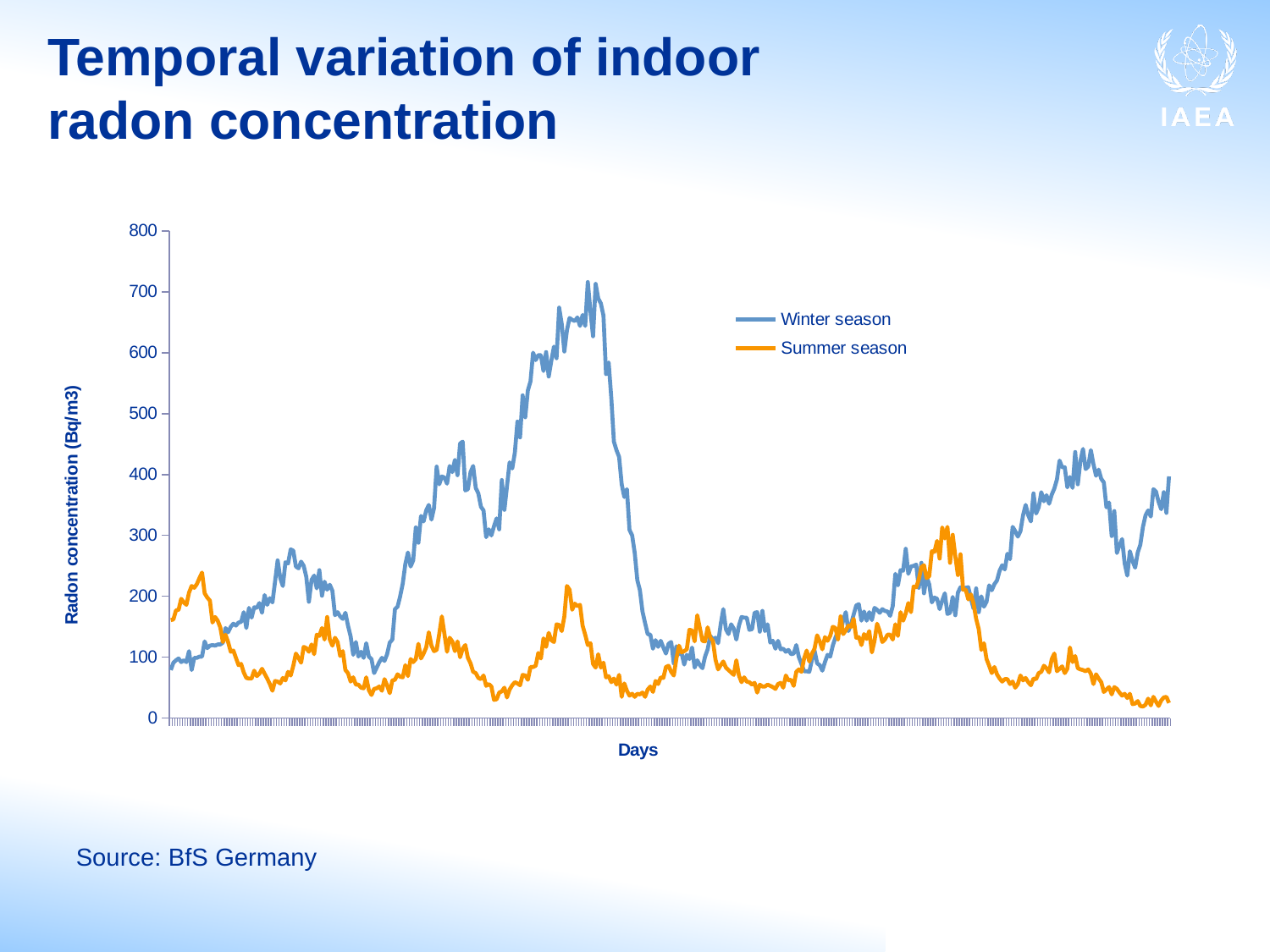
Is the peak value of the Summer season series greater or less than 400? less What are the two series named in the legend? Winter season and Summer season Does the Winter season series ever exceed 500 Bq/m3? Yes How many series does the legend list? 2 What kind of chart is shown on the slide? Line chart What is the maximum value shown on the y axis? 800 What is the label of the y axis? Radon concentration (Bq/m3) Is the lowest value of the Summer season series greater or less than 100? less Which series reaches the highest radon concentration on the chart? Winter season Which series has the higher peak value, Winter season or Summer season? Winter season